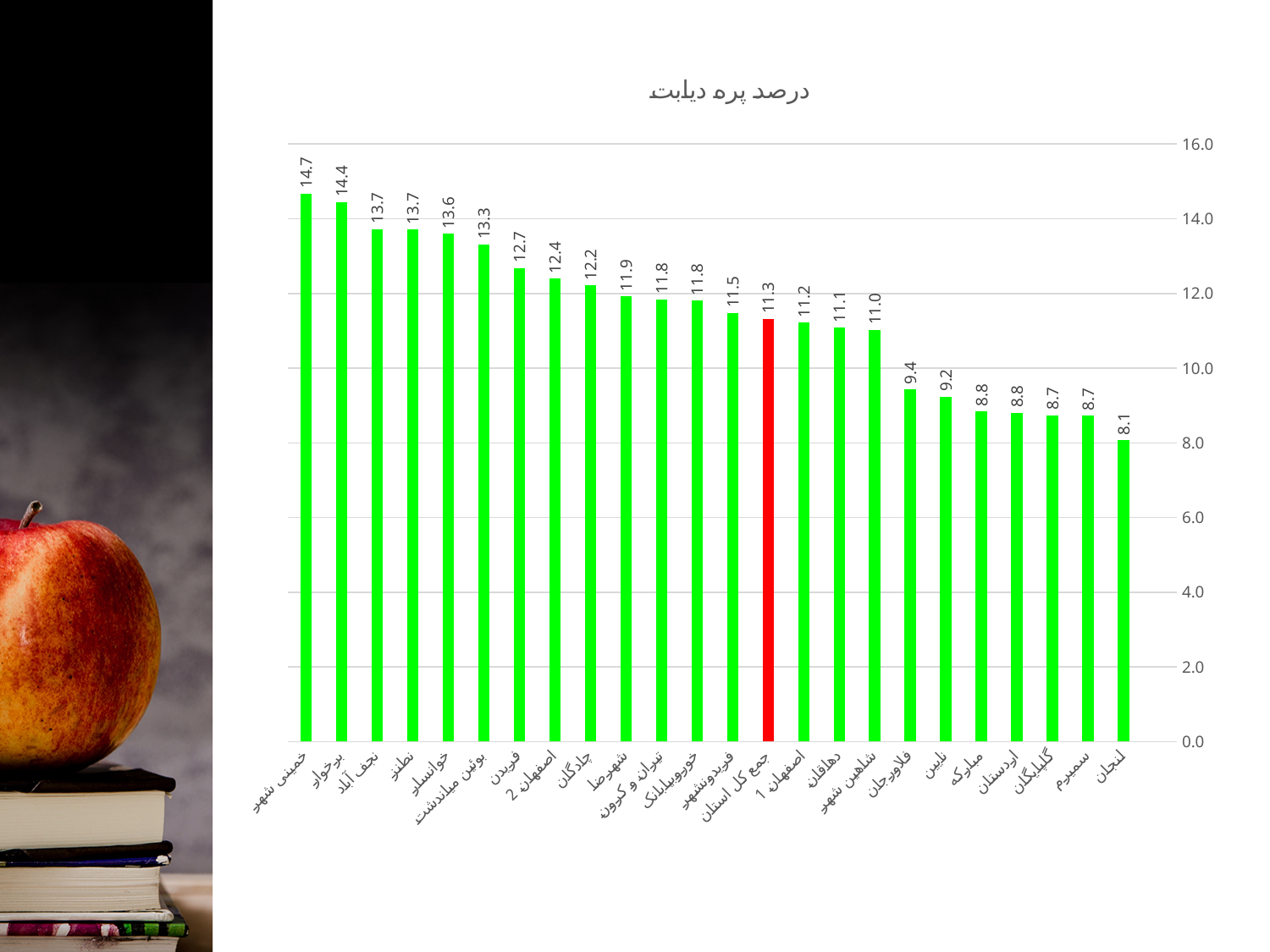
Which bar is coloured red instead of green? جمع کل استان Which category has the lowest value? لنجان What is the value for لنجان? 8.1 What is the value for جمع کل استان? 11.3 What is the value for خمینی شهر? 14.7 Do the values rise or fall from left to right along the x axis? fall What type of chart is shown on the slide? bar chart Which category has the highest value? خمینی شهر How many bars are plotted in the chart? 24 What is the difference between the values for خمینی شهر and لنجان? 6.6 Which is larger, the value for برخوار or the value for فریدن? برخوار What is the value for فلاورجان? 9.4